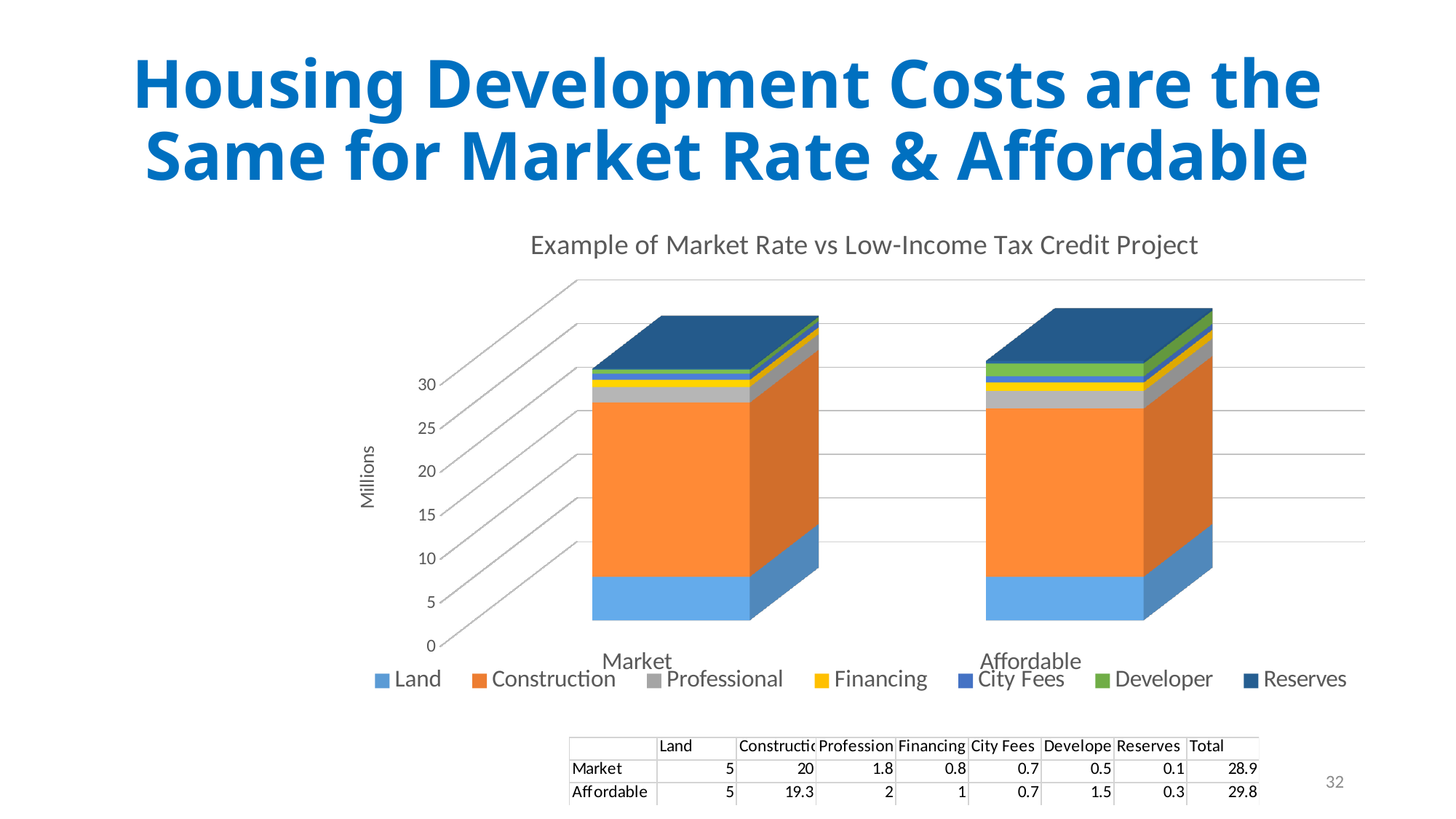
What is the Construction value for Affordable? 19.3 What kind of chart is shown on the slide? stacked bar chart What is the difference between the Developer values for Affordable and Market? 1 How many categories are shown on the x axis? 2 What is the Construction value for Market? 20 What is the Reserves value for Market? 0.1 What is the total of the Affordable stacked bar? 29.8 How many series does the legend list? 7 Which series is the largest component of the Market bar? Construction Which category has the larger Financing value, Market or Affordable? Affordable What is the Developer value for Affordable? 1.5 What is the title of the chart? Example of Market Rate vs Low-Income Tax Credit Project